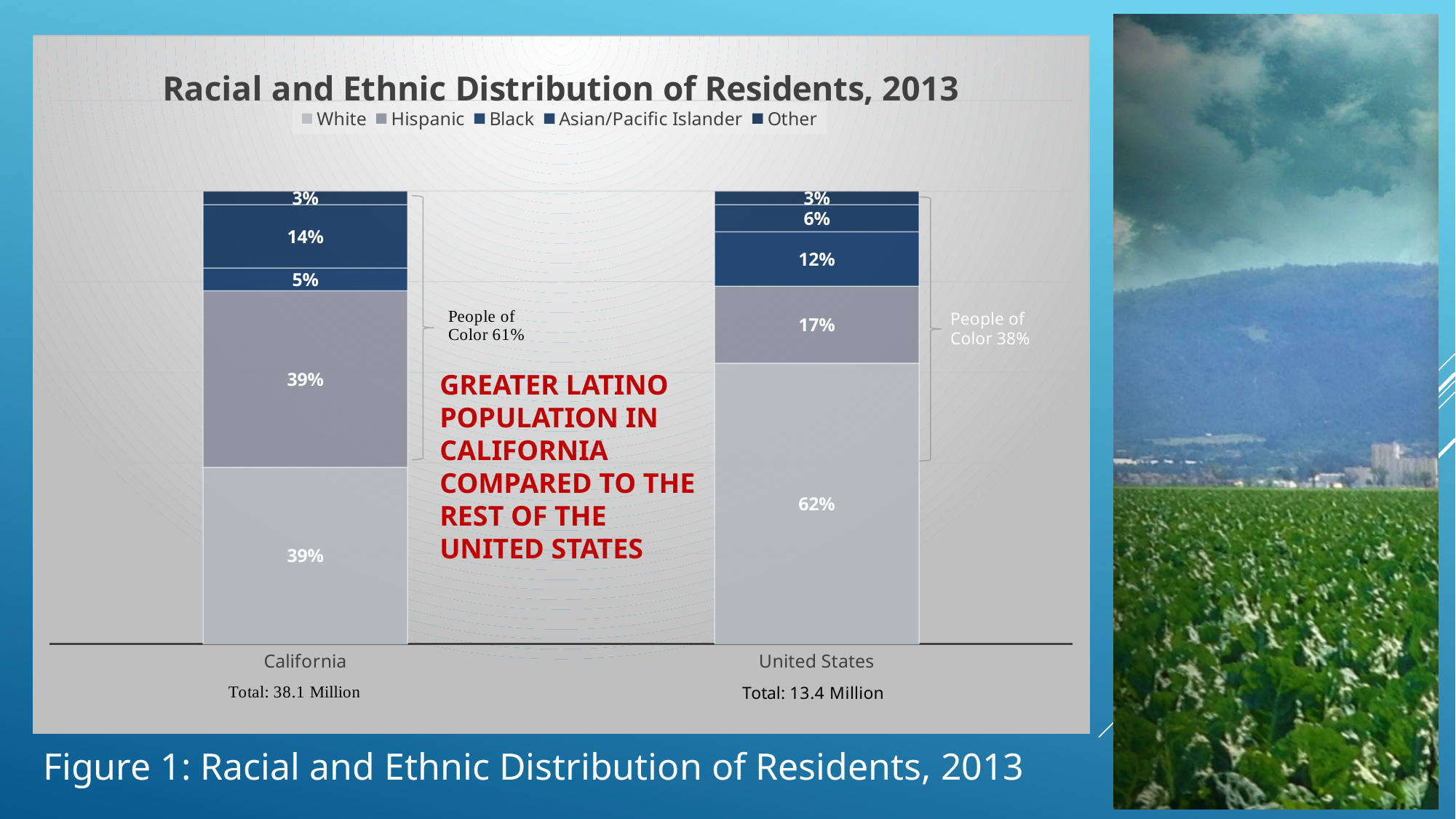
What is the total of the stacked bar for California? 100% What is the Hispanic share for California? 39% Which has the larger Black share, California or the United States? United States What is the title of the chart? Racial and Ethnic Distribution of Residents, 2013 Which has the larger White share, California or the United States? United States What is the Asian/Pacific Islander share for California? 14% What kind of chart is shown on the slide? stacked bar chart What is the White share for the United States? 62% What is the difference between the Hispanic share in California and in the United States? 22% What is the Black share for the United States? 12% How many categories are plotted on the x axis? 2 How many series does the legend list? 5